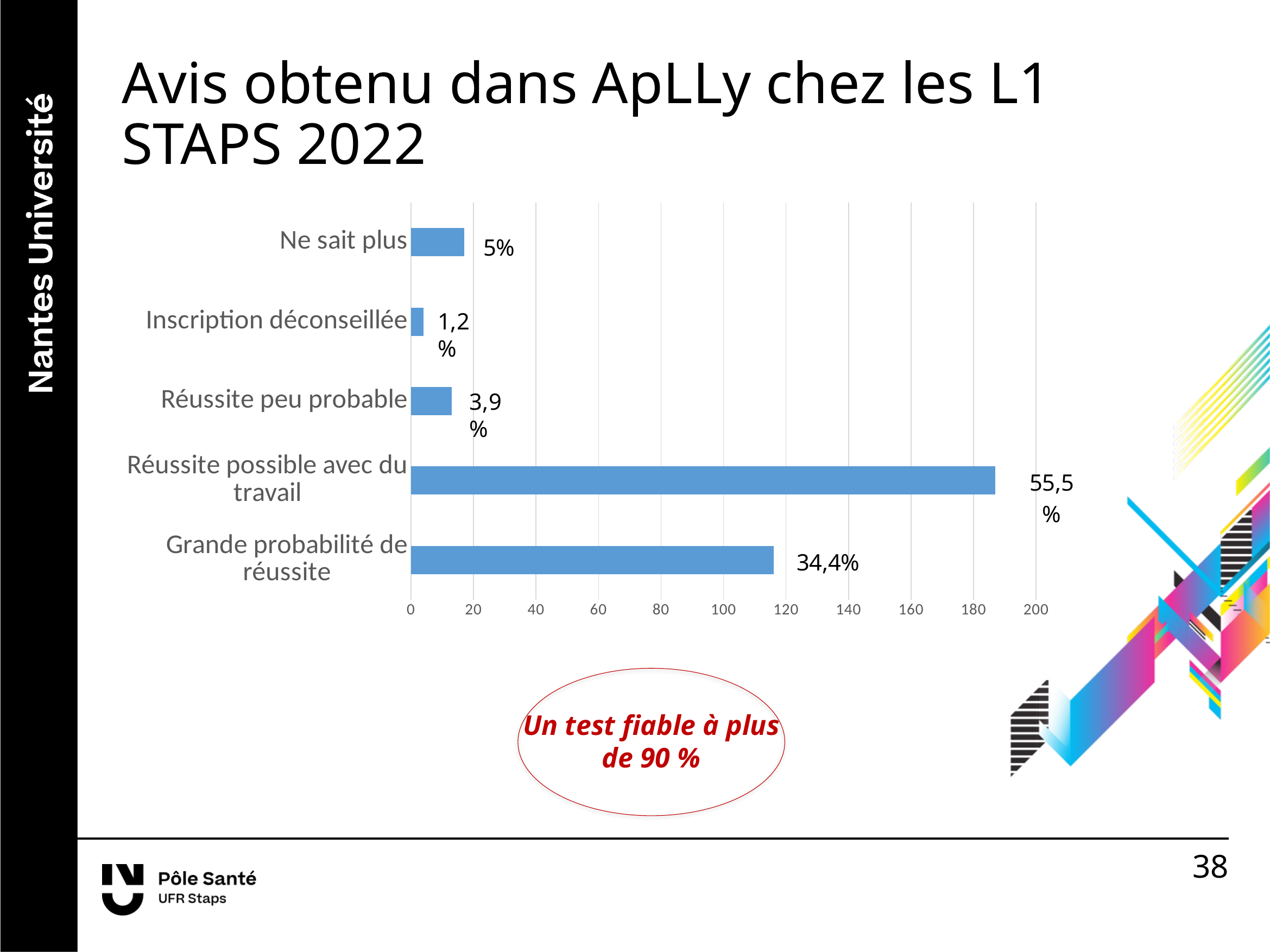
Which category has the shortest bar? Inscription déconseillée On the horizontal axis, is the bar for "Grande probabilité de réussite" greater or less than 100? greater What is the data label shown for "Inscription déconseillée"? 1,2% Which is larger, the value for "Ne sait plus" or the value for "Réussite peu probable"? Ne sait plus What is the difference between the percentage labels for "Réussite possible avec du travail" and "Grande probabilité de réussite"? 21,1% On the horizontal axis, is the bar for "Ne sait plus" greater or less than 20? less What is the data label shown for "Réussite possible avec du travail"? 55,5% Which category has the longest bar? Réussite possible avec du travail What kind of chart is shown on the slide? Bar chart What is the data label shown for "Ne sait plus"? 5% What is the data label shown for "Grande probabilité de réussite"? 34,4% How many categories are shown in the chart? 5